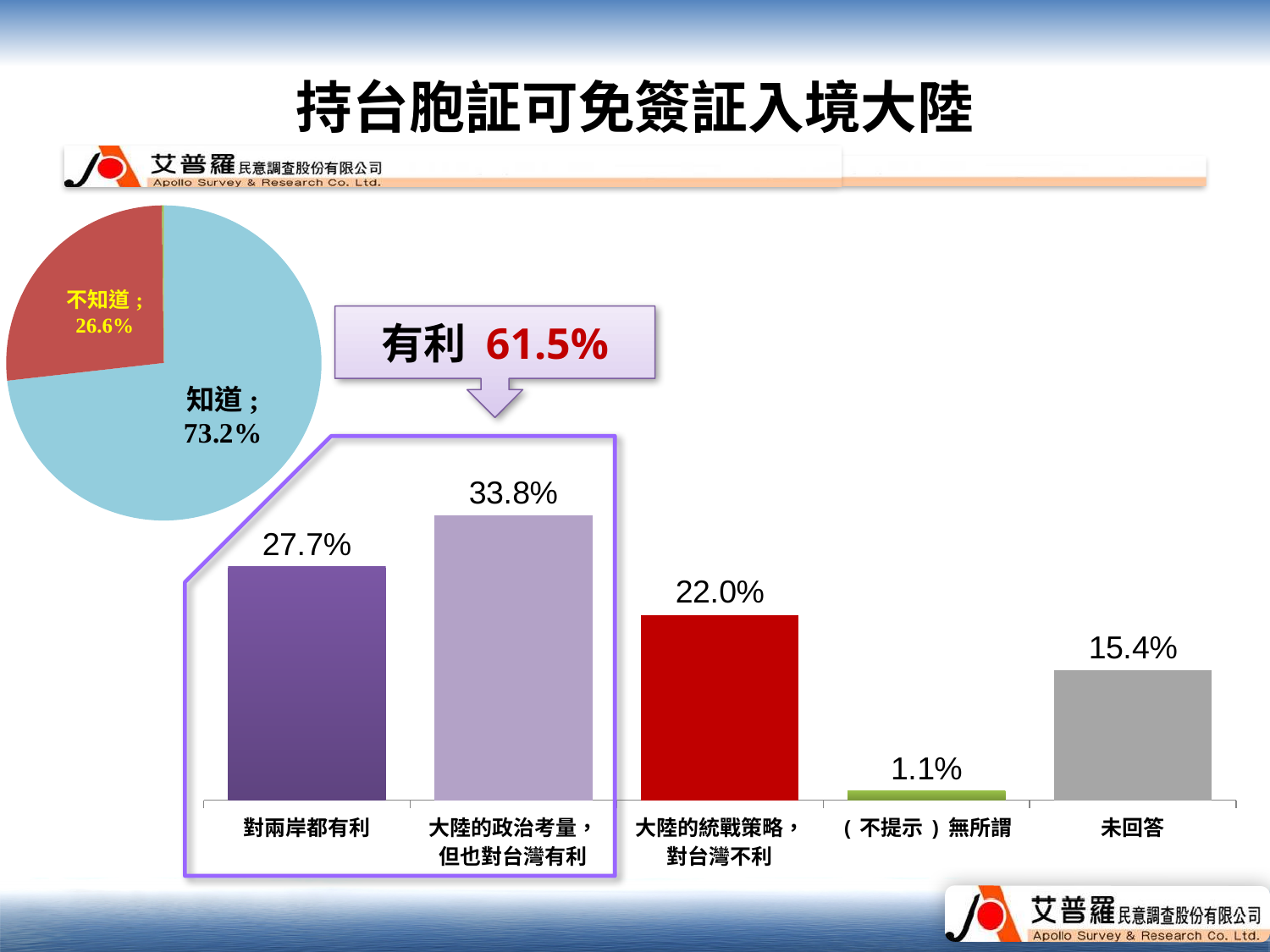
In the pie chart, which slice is larger, 知道 or 不知道? 知道 In the bar chart, which category has the lowest value? （不提示）無所謂 In the bar chart, what is the value for 大陸的統戰策略，對台灣不利? 22.0% In the pie chart, what share is labelled 不知道? 26.6% In the pie chart, what share is labelled 知道? 73.2% What kind of chart is the lower chart on the slide? bar chart In the bar chart, what is the value for 對兩岸都有利? 27.7% In the bar chart, how many categories are shown? 5 In the bar chart, which category has the highest value? 大陸的政治考量，但也對台灣有利 In the bar chart, what is the value for 未回答? 15.4% In the bar chart, what is the difference between 大陸的政治考量，但也對台灣有利 and 對兩岸都有利? 6.1%